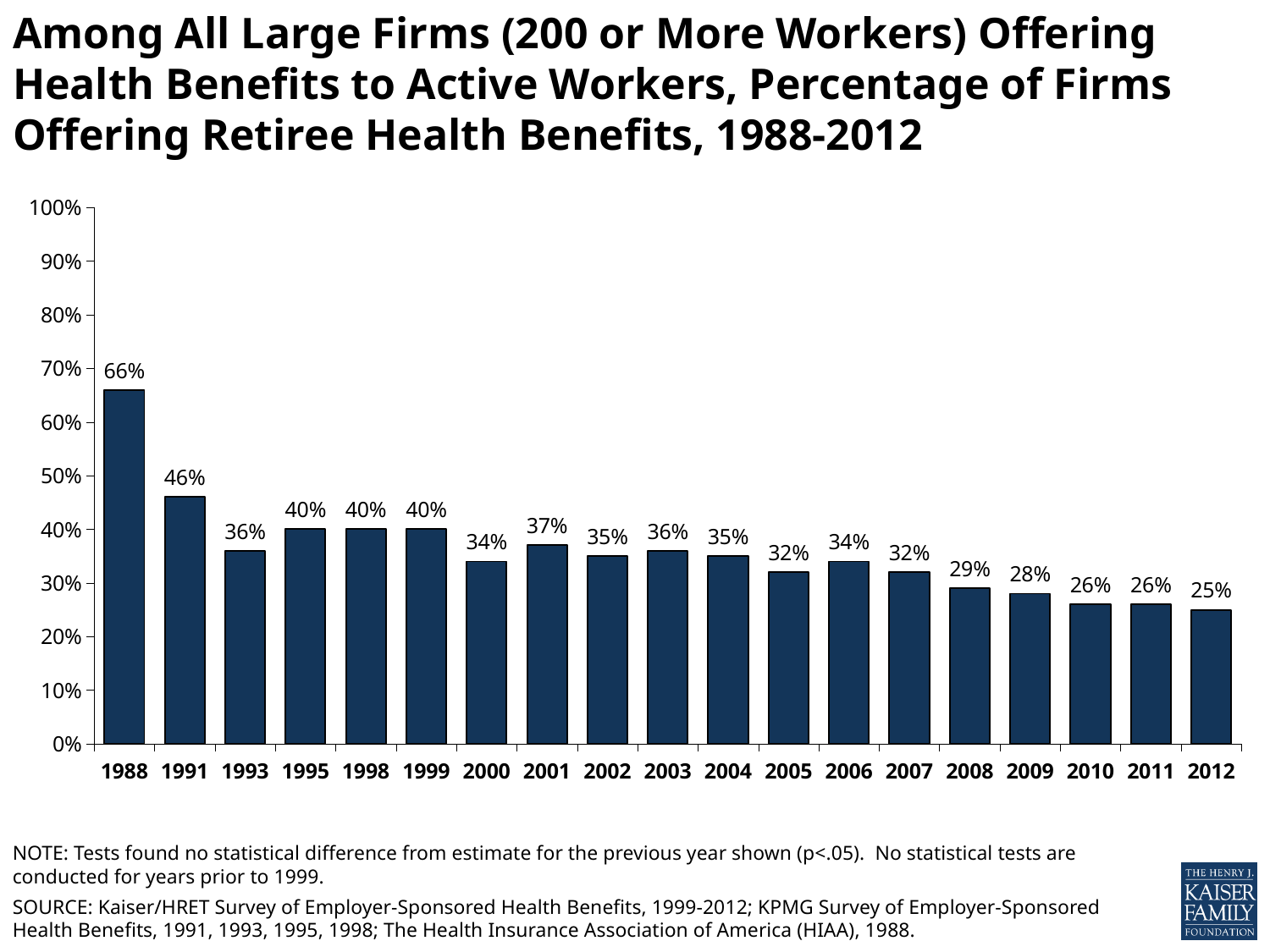
What percentage is shown for 2001? 37% What is the value shown for 2012? 25% Which is larger, the value for 2006 or the value for 2008? 2006 Is the value for 2009 greater or less than 30%? less Do the values generally rise or fall from 1988 to 2012? Fall What percentage of large firms offered retiree health benefits in 1988? 66% Which year has the highest percentage of firms offering retiree health benefits? 1988 How many years are shown on the x axis? 19 What kind of chart is shown on the slide? Bar chart Which year has the lowest percentage of firms offering retiree health benefits? 2012 What is the difference between the values for 1991 and 1993? 10 percentage points What is the difference between the 1988 value and the 2012 value? 41 percentage points